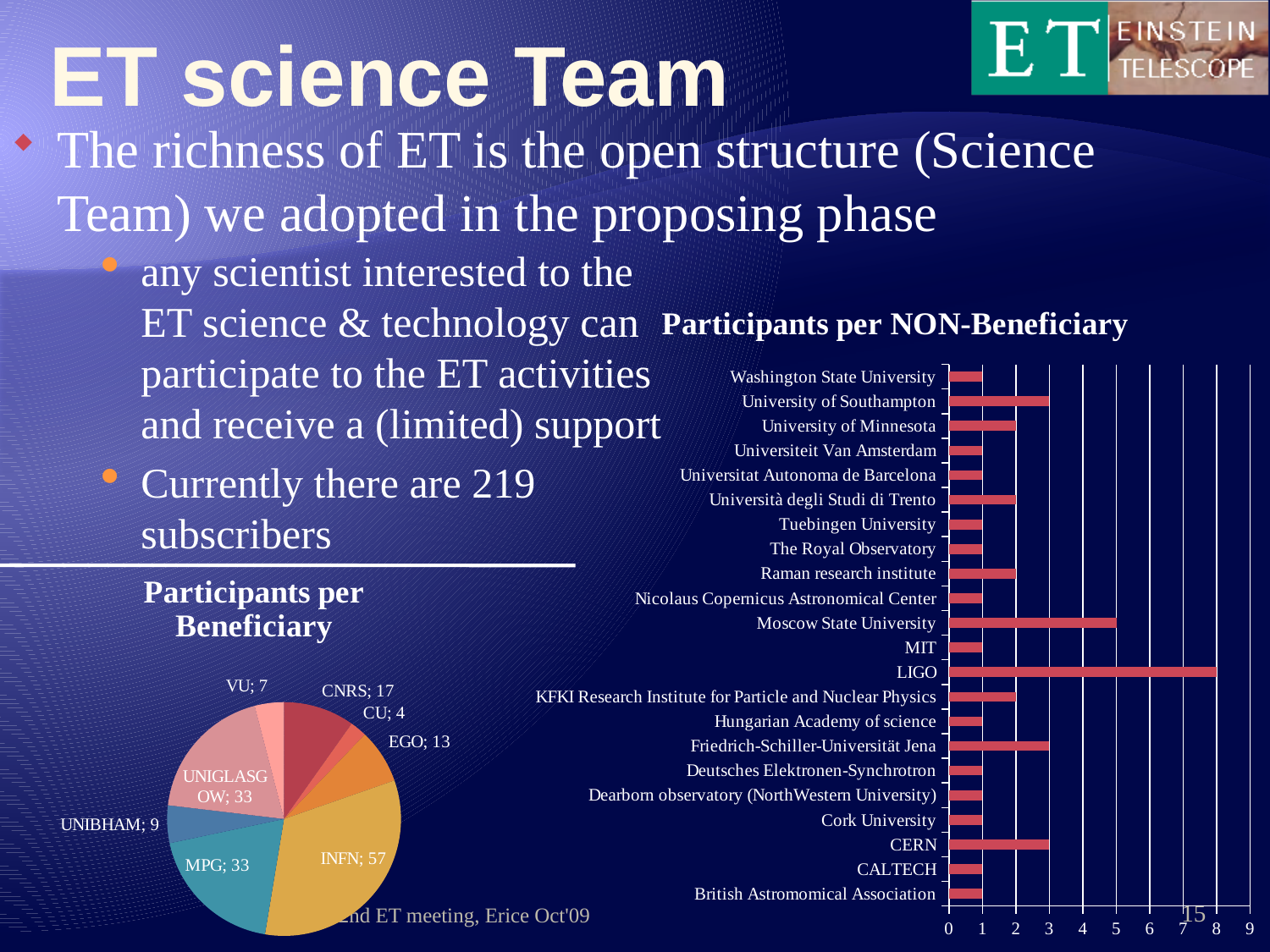
In the 'Participants per NON-Beneficiary' chart, how many participants does Moscow State University have? 5 In the 'Participants per Beneficiary' pie chart, which beneficiary has the most participants? INFN In the 'Participants per Beneficiary' pie chart, which beneficiary has the fewest participants? CU In the 'Participants per NON-Beneficiary' chart, which has more participants, University of Southampton or University of Minnesota? University of Southampton In the 'Participants per Beneficiary' pie chart, what is the difference between the INFN and MPG participant counts? 24 In the 'Participants per Beneficiary' pie chart, which has more participants, CNRS or EGO? CNRS In the 'Participants per NON-Beneficiary' chart, which institution has the most participants? LIGO In the 'Participants per NON-Beneficiary' chart, is the value for LIGO greater or less than 7? greater What kind of chart is 'Participants per NON-Beneficiary'? Bar chart In the 'Participants per Beneficiary' pie chart, how many participants does INFN have? 57 How many slices does the 'Participants per Beneficiary' pie chart have? 8 How many institutions are listed in the 'Participants per NON-Beneficiary' chart? 22